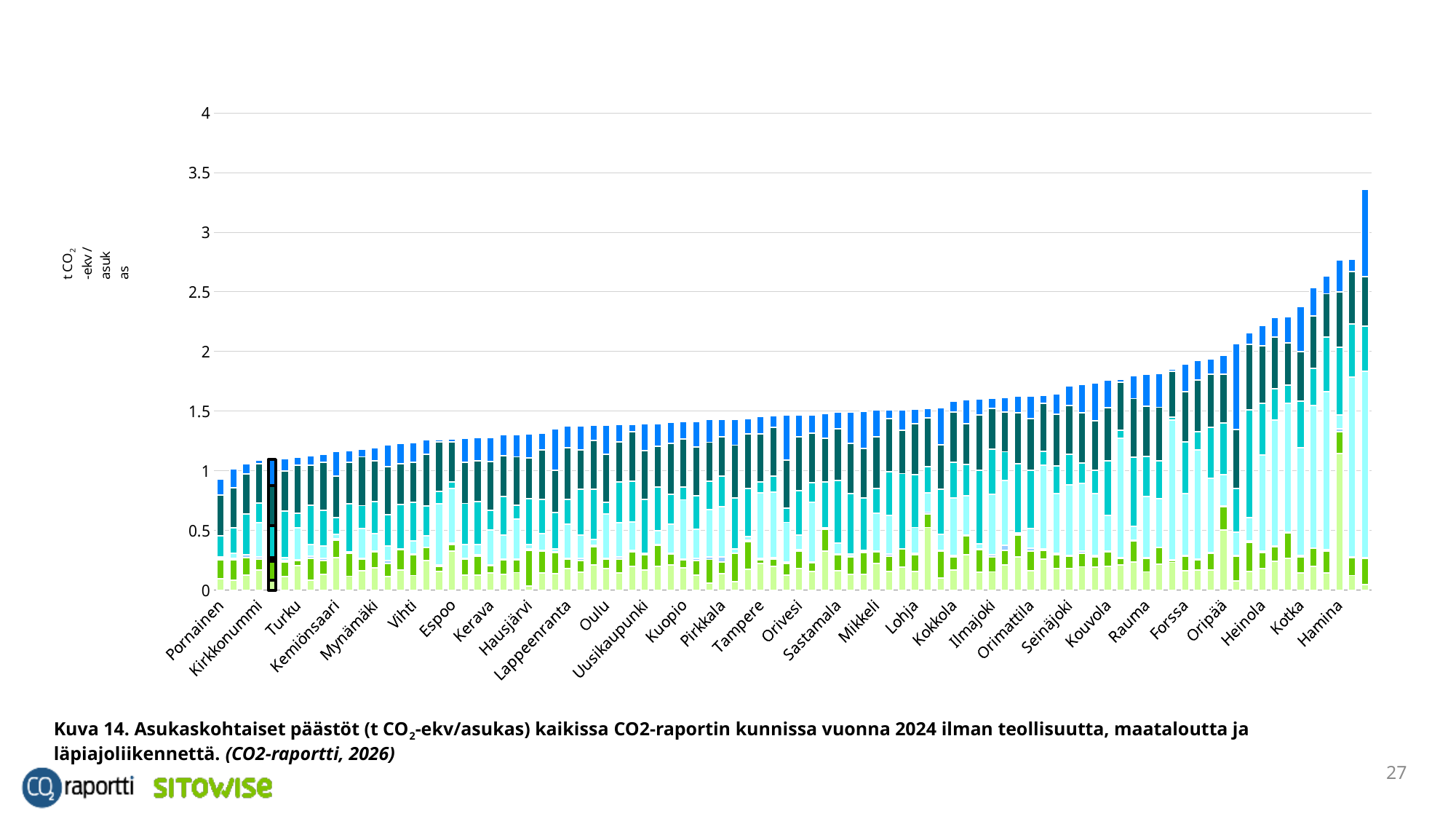
What kind of chart is shown on the slide? Stacked bar chart Is the total value for Kotka greater or less than 2? greater What unit is shown on the y axis of the chart? t CO2-ekv / asukas Which municipality has the lowest per-capita emissions in the chart? Pornainen Which has the larger total, Hamina or Pornainen? Hamina Is the total value for Hamina greater or less than 3? less Is the total value for Turku greater or less than 1.5? less Which has the larger total, Kotka or Turku? Kotka Which year do the emissions in the chart refer to, according to the caption? 2024 Do the bar totals rise or fall from left to right along the x axis? Rise